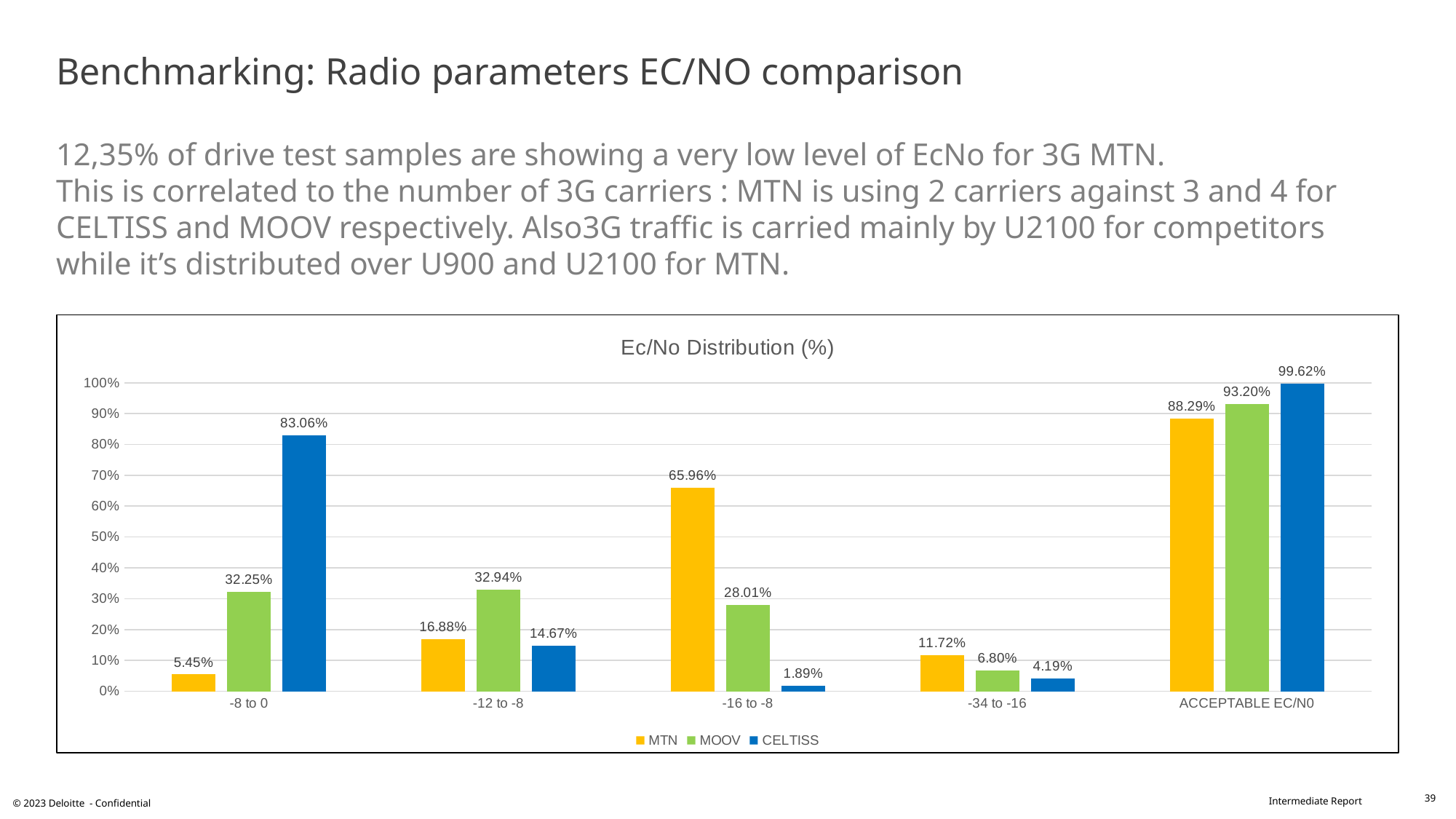
Is the value for CELTISS in the -12 to -8 category greater or less than 20%? less What is the value for MOOV in the ACCEPTABLE EC/N0 category? 93.20% What is the value for CELTISS in the -8 to 0 category? 83.06% What is the title of the chart? Ec/No Distribution (%) Which is larger in the -34 to -16 category: the MTN value or the MOOV value? MTN What is the value for MTN in the -16 to -8 category? 65.96% How many categories are shown on the x axis? 5 What is the difference between the MOOV and MTN values in the -12 to -8 category? 16.06% Which series has the highest value in the ACCEPTABLE EC/N0 category? CELTISS How many series does the legend list? 3 What kind of chart is shown on the slide? Bar chart Which series has the lowest value in the -16 to -8 category? CELTISS